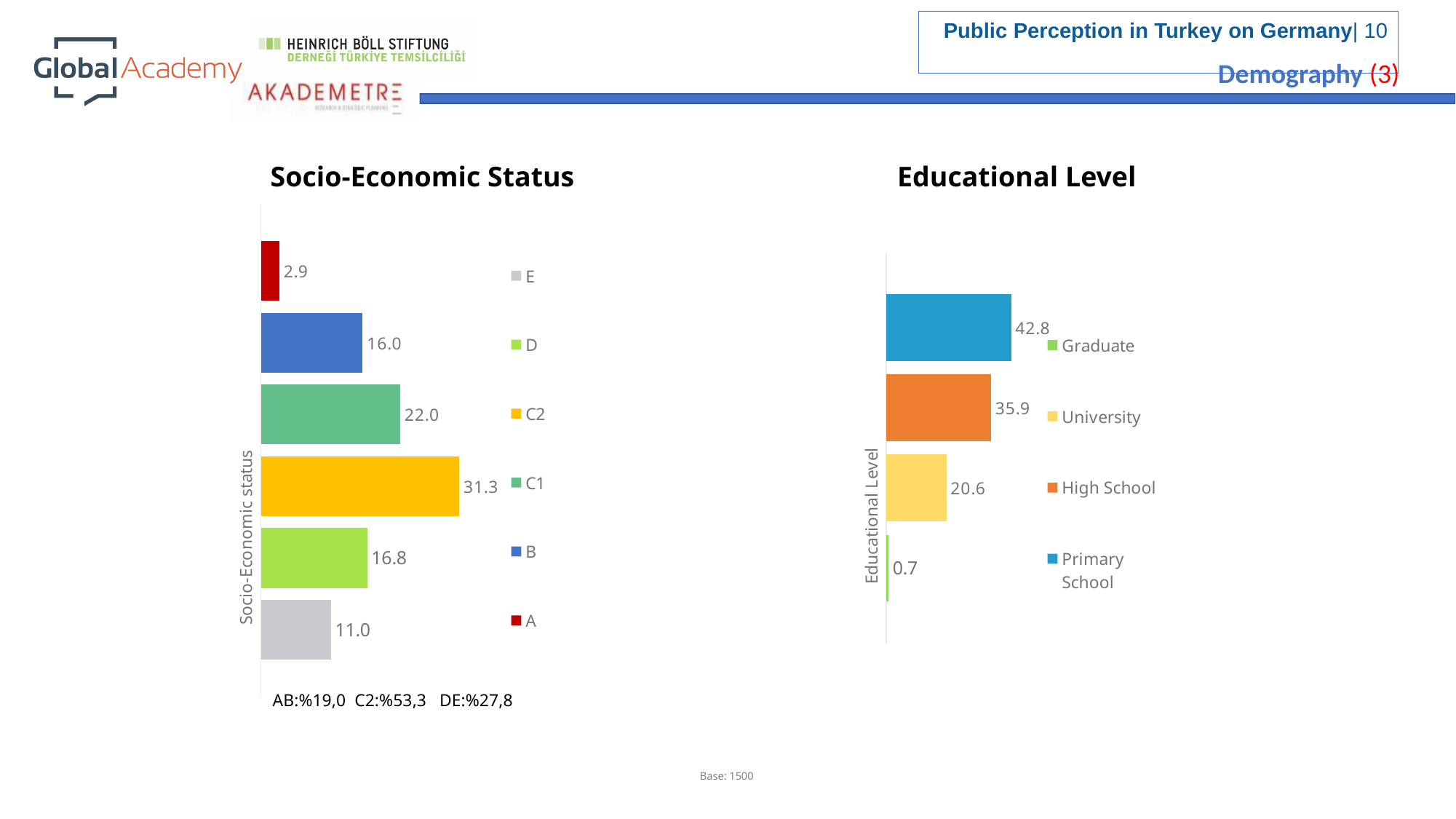
In the Educational Level chart, which is larger, University or High School? High School In the Socio-Economic Status chart, what is the difference between the values for C1 and B? 6.0 In the Educational Level chart, which category has the highest value? Primary School What type of chart is the Educational Level chart? Bar chart In the Socio-Economic Status chart, which category has the lowest value? A In the Socio-Economic Status chart, how many categories are plotted? 6 In the Educational Level chart, what is the difference between the values for Primary School and University? 22.2 In the Socio-Economic Status chart, which category has the highest value? C2 In the Educational Level chart, what is the value for Graduate? 0.7 In the Socio-Economic Status chart, what is the value for C2? 31.3 In the Educational Level chart, what is the value for High School? 35.9 In the Socio-Economic Status chart, what is the value for A? 2.9